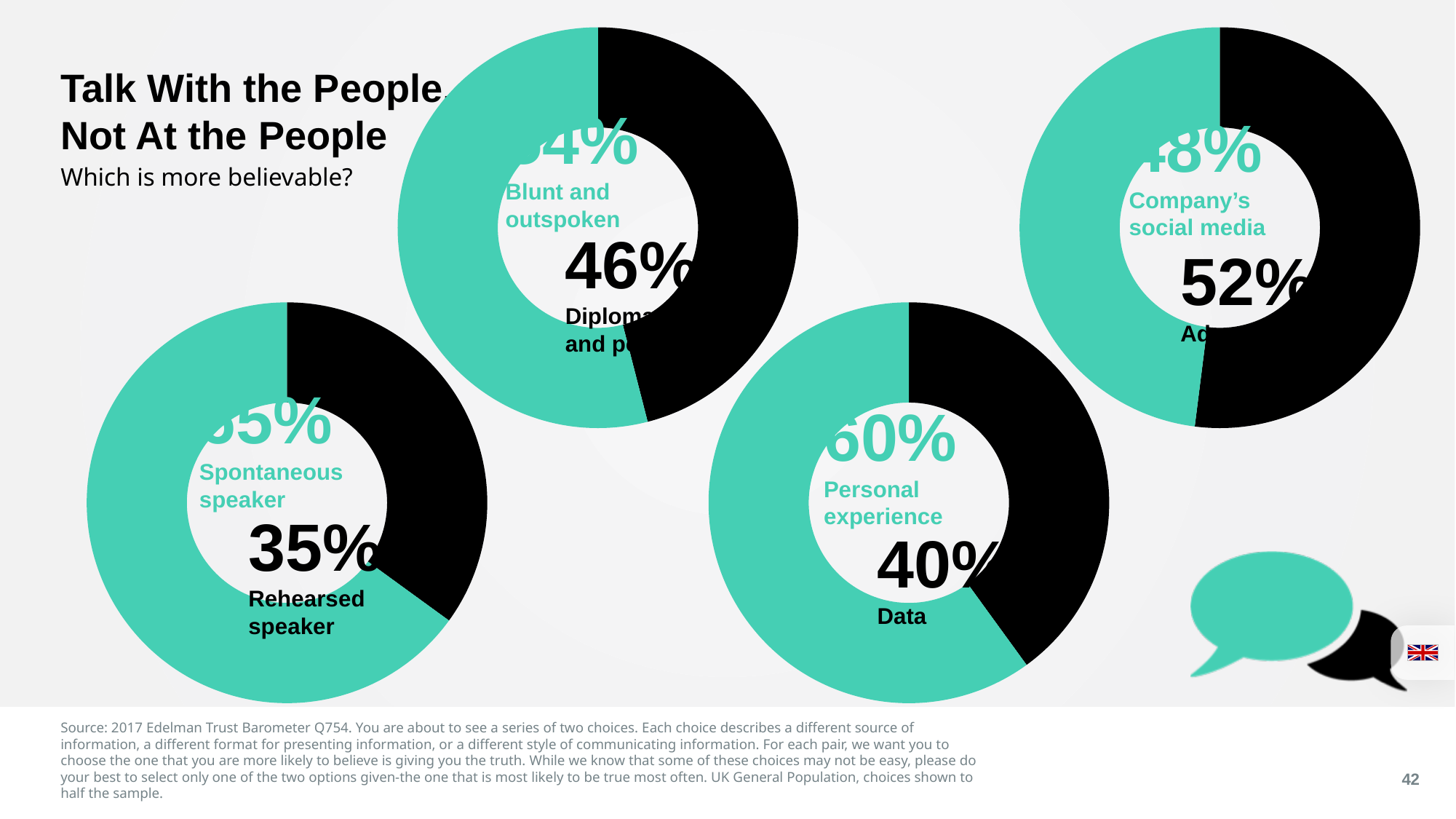
What question does the slide subtitle ask? Which is more believable? In the bottom-left chart, which is larger: Spontaneous speaker or Rehearsed speaker? Spontaneous speaker How many charts are shown on the slide? 4 In the bottom-middle chart, what percentage is shown for Data? 40% What kind of chart is used on this slide? Donut chart In the bottom-left chart, is the value for Rehearsed speaker greater or less than 50%? less In the bottom-middle chart, what is the difference between Personal experience and Data? 20% In the top-right chart, what value is printed in black? 52% In the top-middle chart, what value is printed in black? 46% In the bottom-left chart, what percentage is shown for Rehearsed speaker? 35% In the bottom-middle chart, what percentage is shown for Personal experience? 60% In the bottom-middle chart, which is larger: Personal experience or Data? Personal experience